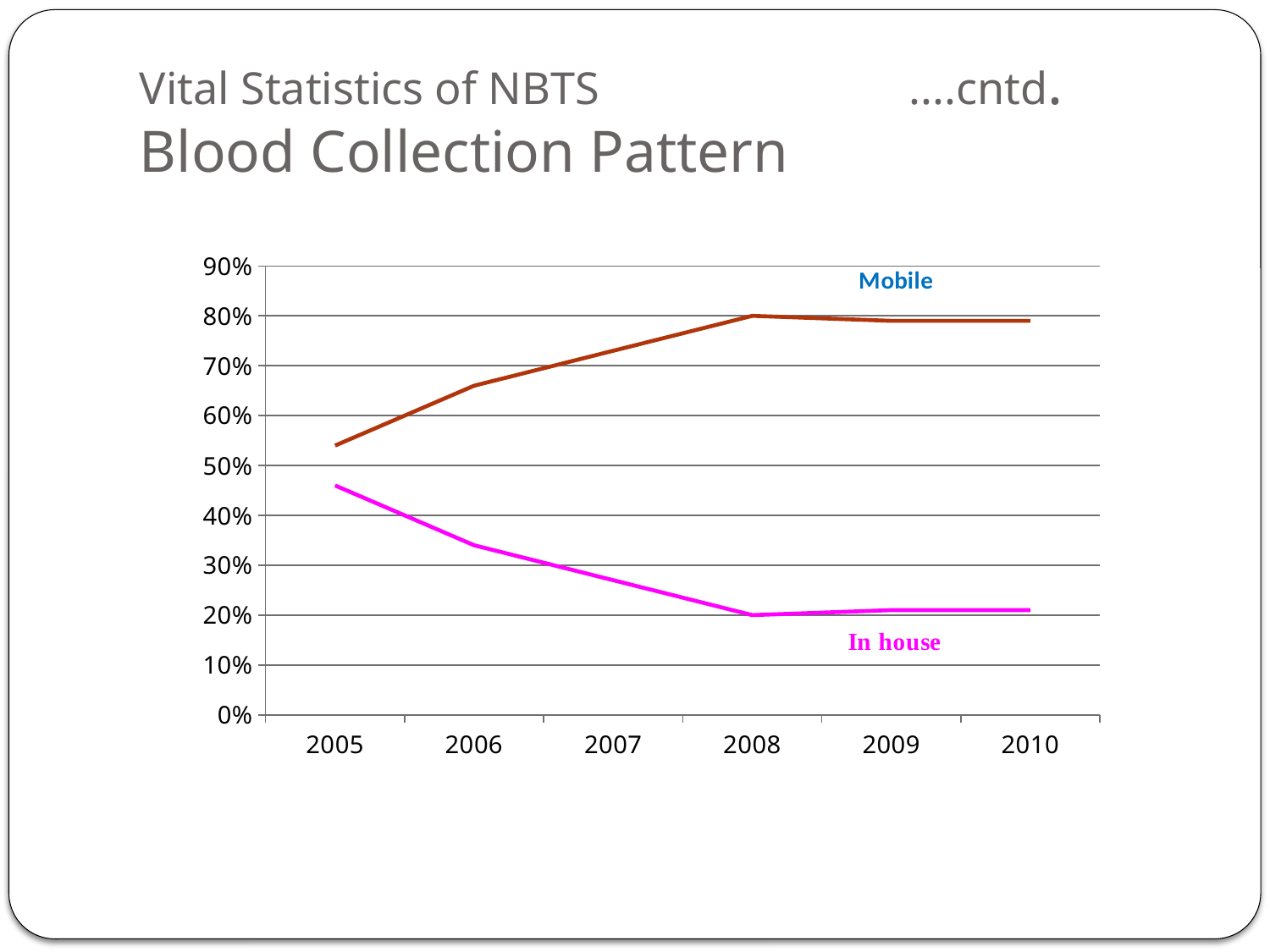
What kind of chart is shown on the slide? line chart Which series has the larger value in 2005, Mobile or In house? Mobile What is the value for Mobile in 2008? 80% Is the value for Mobile in 2005 greater or less than 50%? greater In which year is the In house value highest? 2005 Is the value for In house in 2006 greater or less than 30%? greater What is the value for In house in 2008? 20% How many series are plotted on the chart? 2 Is the value for In house in 2005 greater or less than 50%? less How many years are shown on the x axis of the chart? 6 Does the In house series rise or fall from 2005 to 2008? fall In which year is the Mobile value highest? 2008